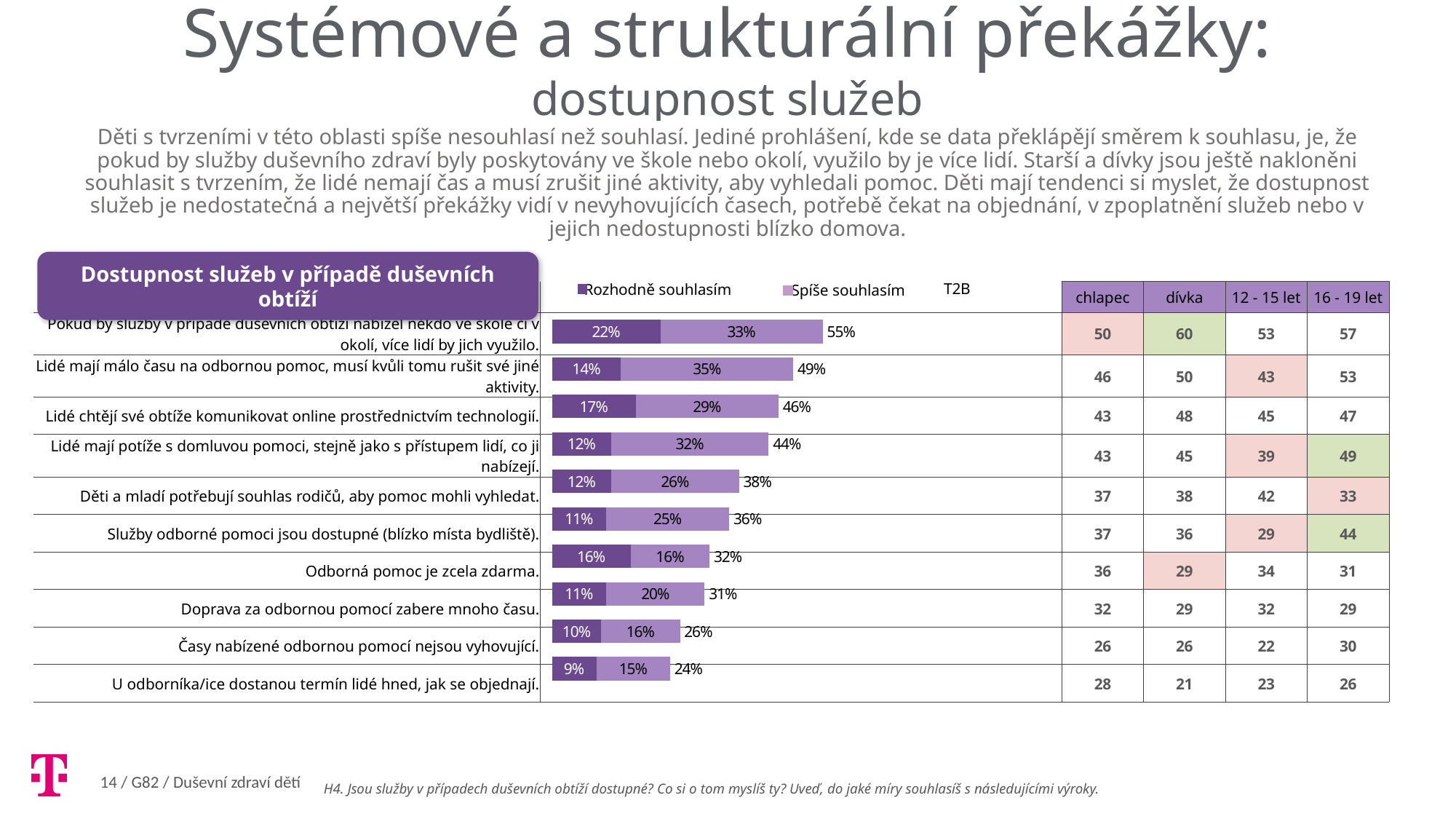
Which is larger: the 'Spíše souhlasím' value for 'Doprava za odbornou pomocí zabere mnoho času.' or for 'Časy nabízené odbornou pomocí nejsou vyhovující.'? Doprava za odbornou pomocí zabere mnoho času. Which statement has the highest T2B total? Pokud by služby v případě duševních obtíží nabízel někdo ve škole či v okolí, více lidí by jich využilo. What is the 'Spíše souhlasím' value for 'Lidé mají málo času na odbornou pomoc, musí kvůli tomu rušit své jiné aktivity.'? 35% How many statements (categories) are plotted in the chart? 10 What is the T2B total for 'Lidé chtějí své obtíže komunikovat online prostřednictvím technologií.'? 46% Which legend entry is shown in the darker purple colour? Rozhodně souhlasím How many series does the chart legend list? 2 What is the difference between the T2B totals for 'Děti a mladí potřebují souhlas rodičů, aby pomoc mohli vyhledat.' and 'Služby odborné pomoci jsou dostupné (blízko místa bydliště).'? 2% Do the T2B totals rise or fall going down the list of statements from top to bottom? fall What is the 'Rozhodně souhlasím' value for 'Odborná pomoc je zcela zdarma.'? 16% Which statement has the lowest 'Rozhodně souhlasím' value? U odborníka/ice dostanou termín lidé hned, jak se objednají. What kind of chart is shown on the slide? stacked bar chart